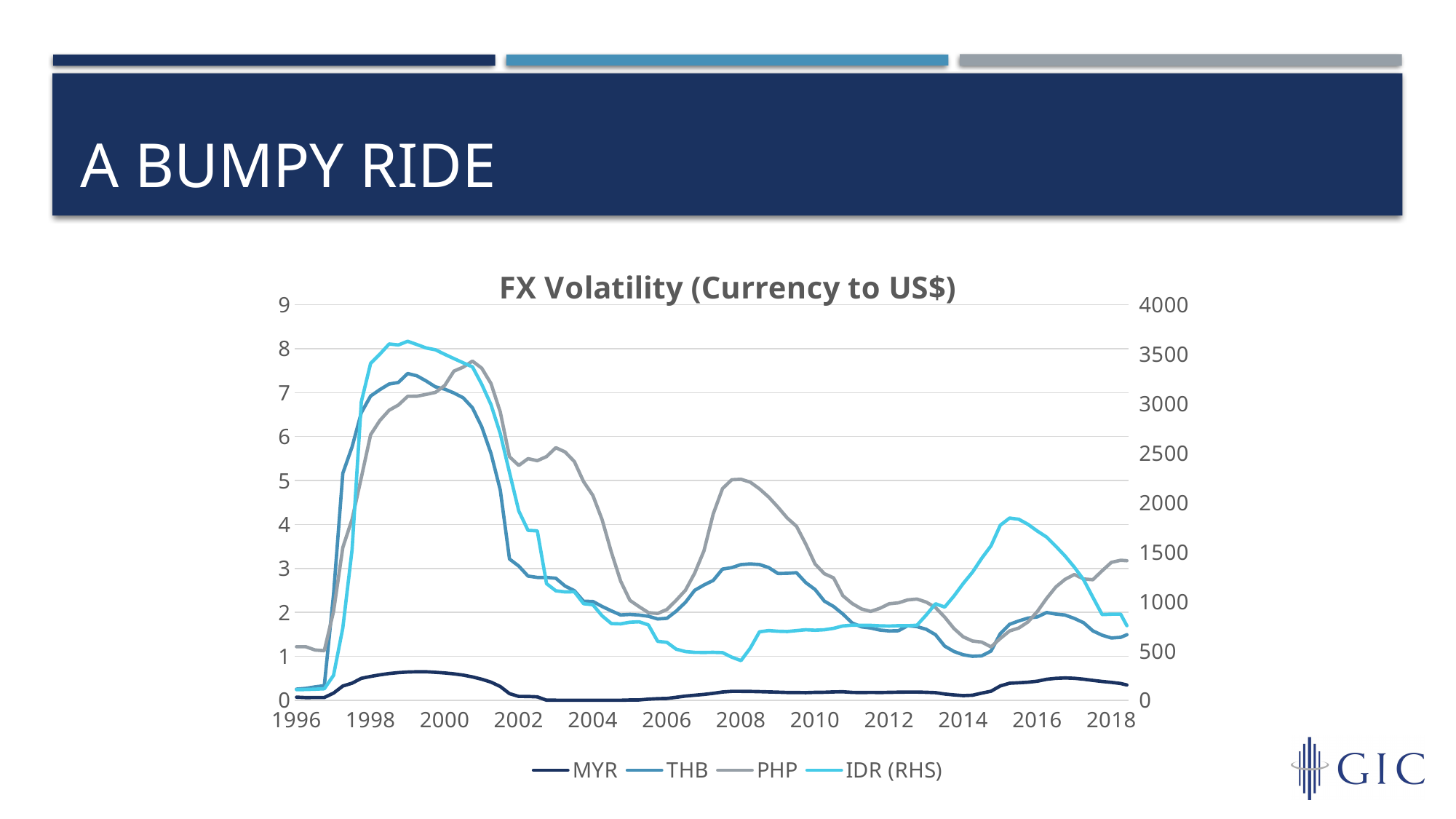
Does the PHP line rise or fall between 2008 and 2012? fall What is the title of the chart? FX Volatility (Currency to US$) How many year labels are shown on the x axis? 12 Is the value for PHP in 2008 greater or less than 4? greater In 2008, which is higher, PHP or THB? PHP What kind of chart is shown on the slide? line chart Which series is plotted against the right-hand axis? IDR (RHS) How many series does the legend list? 4 Is the value for IDR (RHS) in 2016 greater or less than 1500? greater Which series stays lowest on the chart across the whole period? MYR Is the value for IDR (RHS) in 2008 greater or less than 500? less